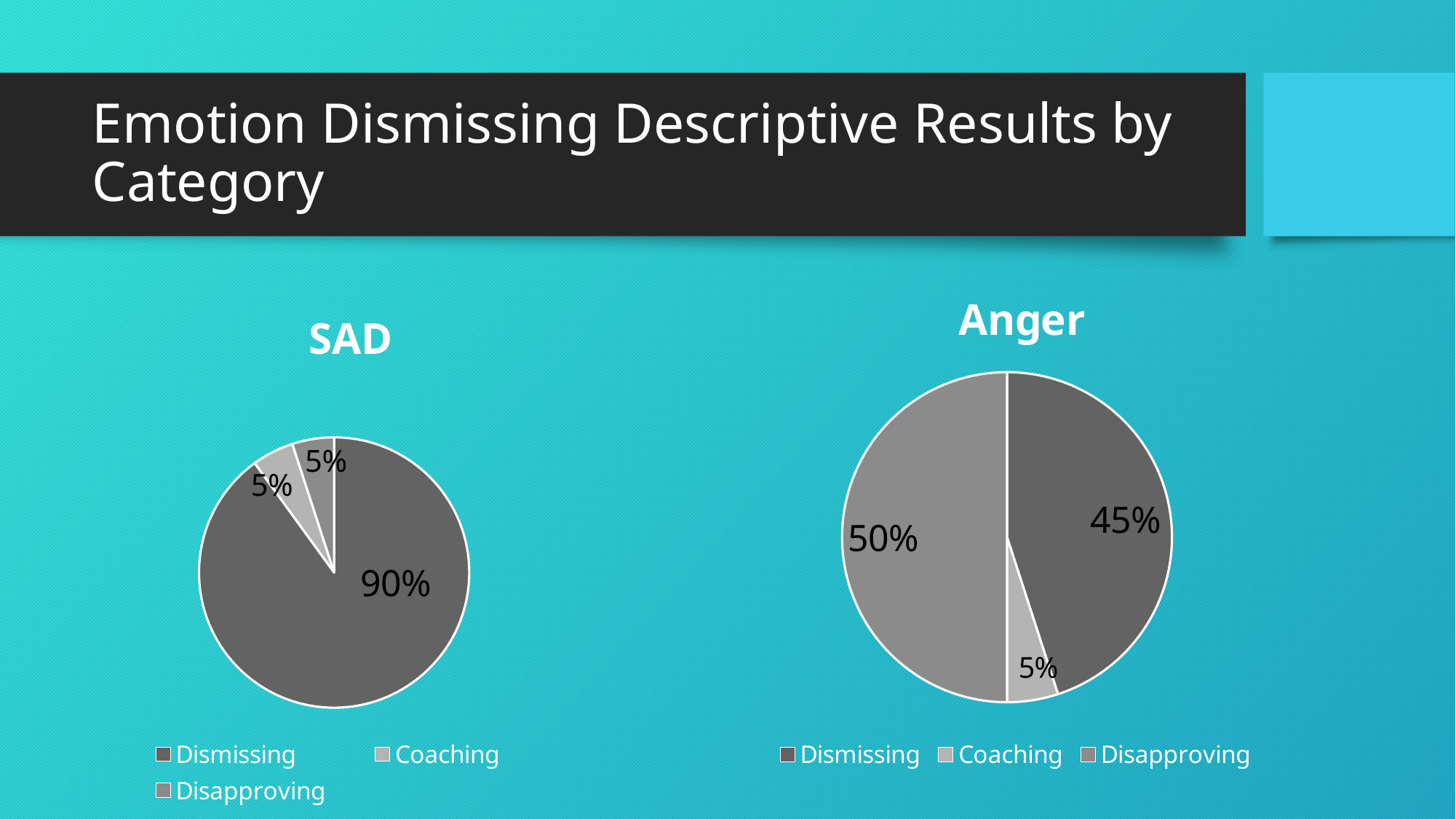
How many categories does the legend of the Anger chart list? 3 In the SAD pie chart, what percentage is shown for Dismissing? 90% In the Anger pie chart, what percentage is shown for Dismissing? 45% In the Anger pie chart, which is larger, Dismissing or Disapproving? Disapproving In the Anger pie chart, which category has the smallest share? Coaching In the Anger pie chart, which category has the largest share? Disapproving In the Anger pie chart, what is the difference between the Disapproving and Dismissing percentages? 5% In the SAD pie chart, what percentage is shown for Coaching? 5% What type of chart is used for the SAD data? Pie chart In the Anger pie chart, what percentage is shown for Coaching? 5% In the Anger pie chart, what percentage is shown for Disapproving? 50% In the SAD pie chart, which category has the largest share? Dismissing